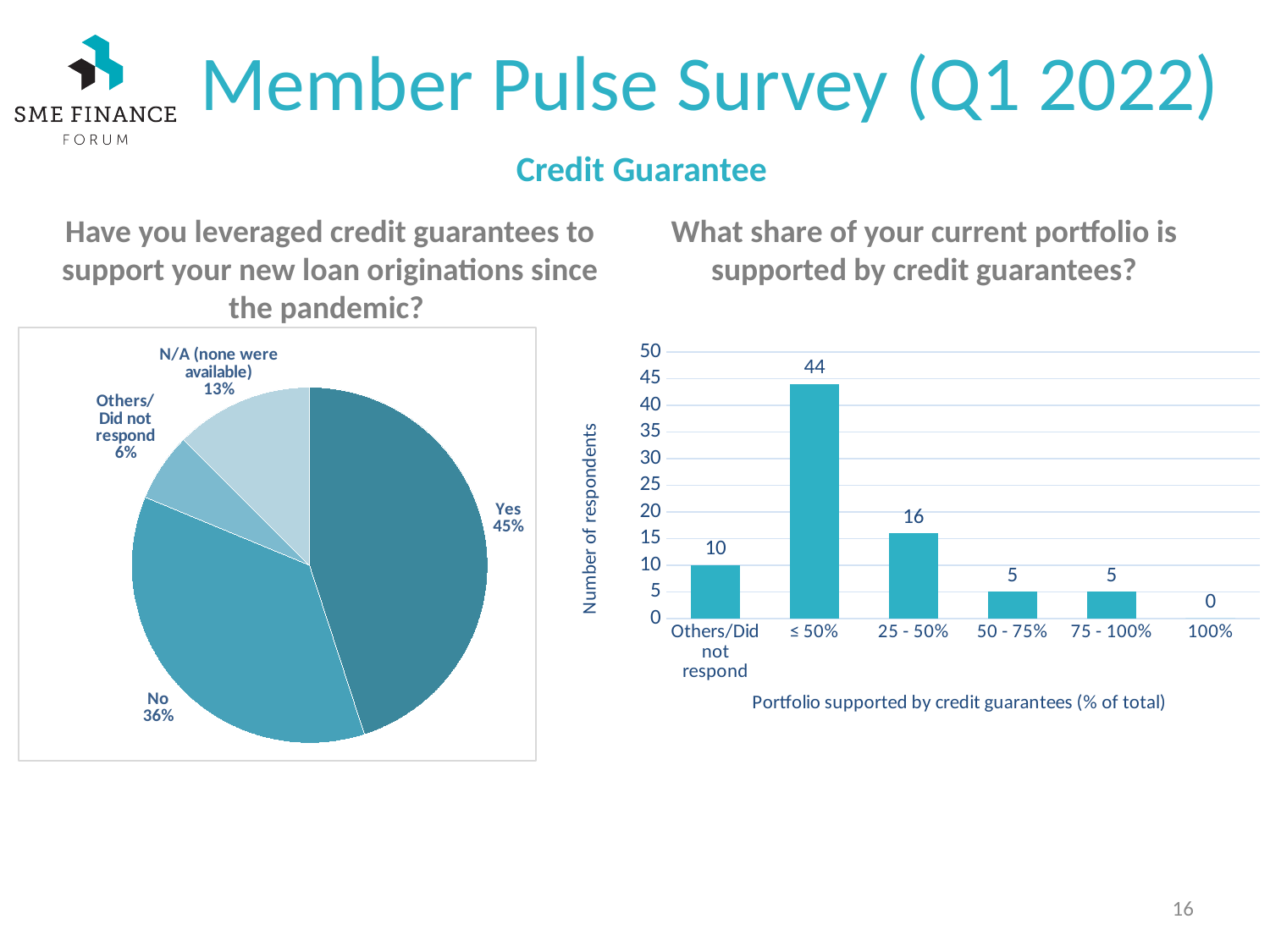
In the pie chart on the left, what share of respondents answered 'No'? 36% In the pie chart on the left, which category has the largest share? Yes In the pie chart on the left, what share of respondents answered 'Yes'? 45% In the pie chart on the left, what share is labelled 'N/A (none were available)'? 13% In the bar chart on the right, how many respondents are in the '25 - 50%' category? 16 In the pie chart on the left, how many slices are there? 4 In the bar chart on the right, how many categories are shown on the x axis? 6 What type of chart is shown on the right side of the slide? Bar chart In the bar chart on the right, what is the difference in respondents between '≤ 50%' and '25 - 50%'? 28 In the bar chart on the right, which category has the highest number of respondents? ≤ 50% In the pie chart on the left, which category has the smallest share? Others/Did not respond In the bar chart on the right, how many respondents are in the '≤ 50%' category? 44